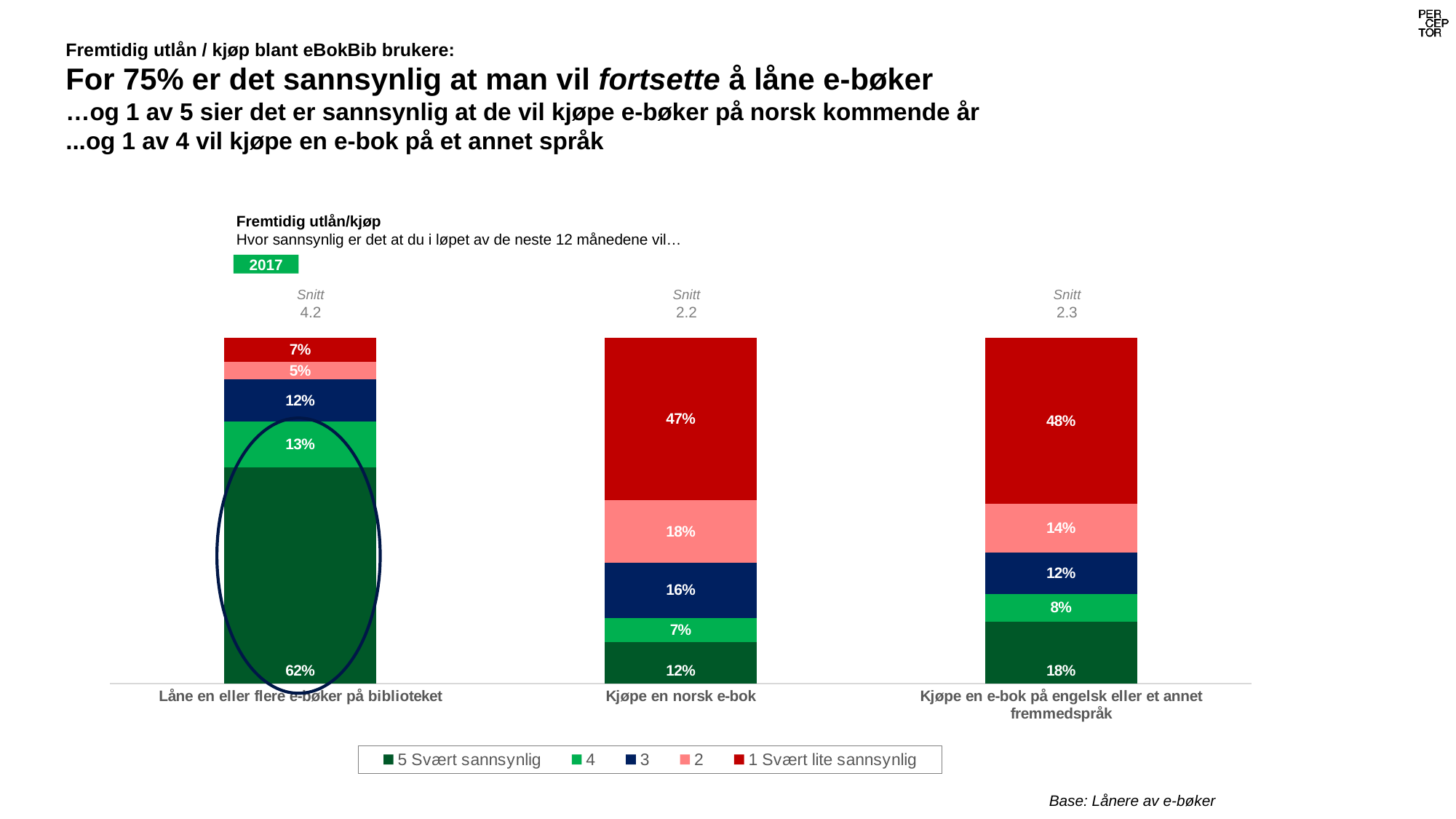
How many categories are shown on the x axis? 3 What is the difference between the "1 Svært lite sannsynlig" shares for "Kjøpe en e-bok på engelsk eller et annet fremmedspråk" and "Kjøpe en norsk e-bok"? 1% What is the "Snitt" (average) shown above the bar for "Låne en eller flere e-bøker på biblioteket"? 4.2 What percentage of respondents answered "5 Svært sannsynlig" for "Låne en eller flere e-bøker på biblioteket"? 62% How many series does the legend list? 5 What percentage answered "1 Svært lite sannsynlig" for "Kjøpe en norsk e-bok"? 47% What is the value of the "2" segment for "Kjøpe en e-bok på engelsk eller et annet fremmedspråk"? 14% Which is larger: the "3" segment for "Kjøpe en norsk e-bok" or the "3" segment for "Kjøpe en e-bok på engelsk eller et annet fremmedspråk"? Kjøpe en norsk e-bok Which category has the highest share of "5 Svært sannsynlig" responses? Låne en eller flere e-bøker på biblioteket What kind of chart is shown on the slide? Stacked bar chart Which category has the lowest share of "1 Svært lite sannsynlig" responses? Låne en eller flere e-bøker på biblioteket